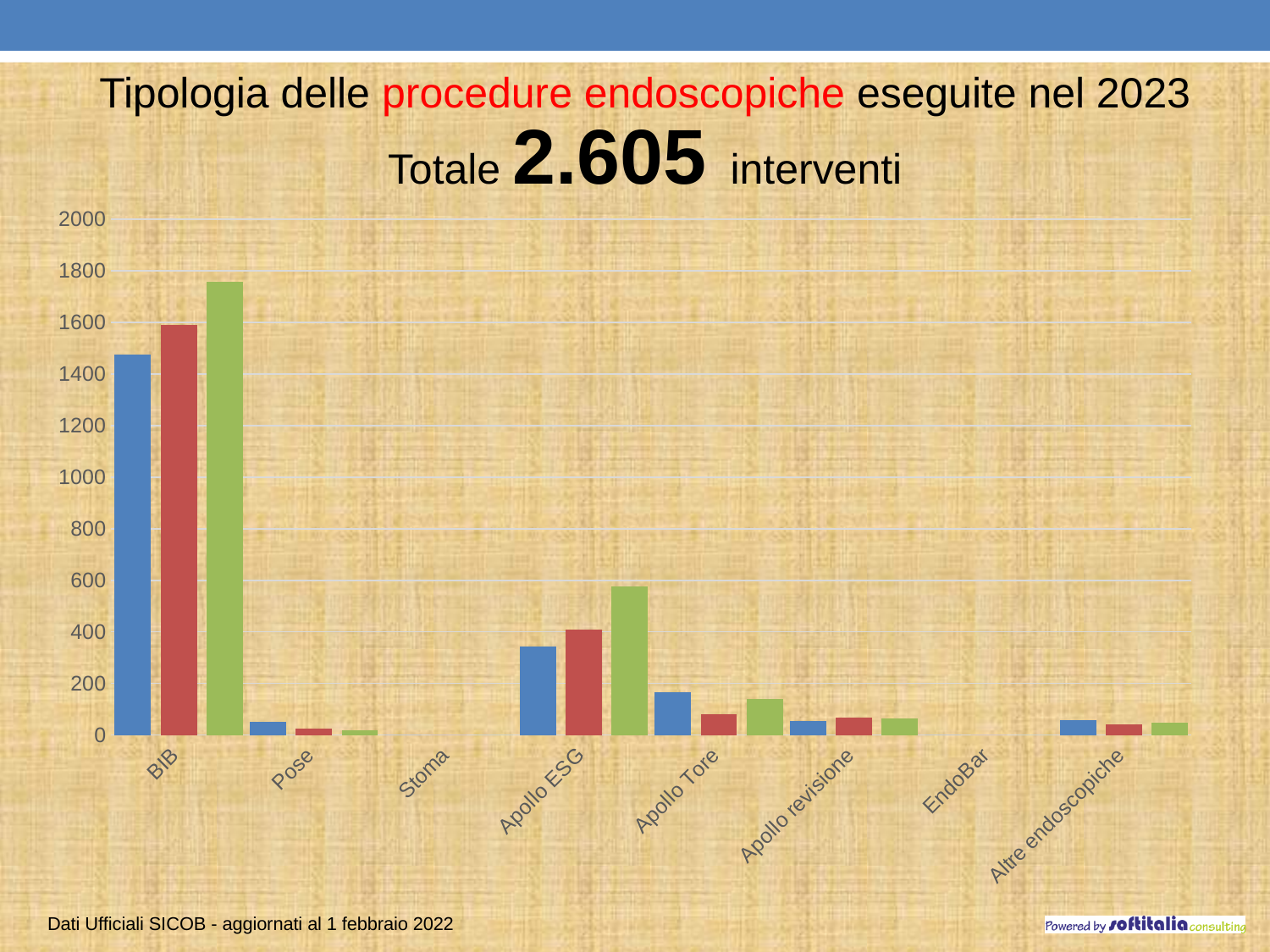
What total number of interventions is stated in the slide title? 2.605 What kind of chart is shown on the slide? bar chart Which category has the larger green bar, Apollo ESG or Apollo Tore? Apollo ESG How many categories are shown on the x axis of the chart? 8 How many different bar colours are used in the chart? 3 Is the value of the blue bar for BIB greater or less than 1400? greater Is the value of the green bar for BIB greater or less than 1600? greater Is the value of the green bar for Apollo ESG greater or less than 400? greater Which category has the tallest bars in the chart? BIB Which category has the larger blue bar, Pose or Apollo ESG? Apollo ESG